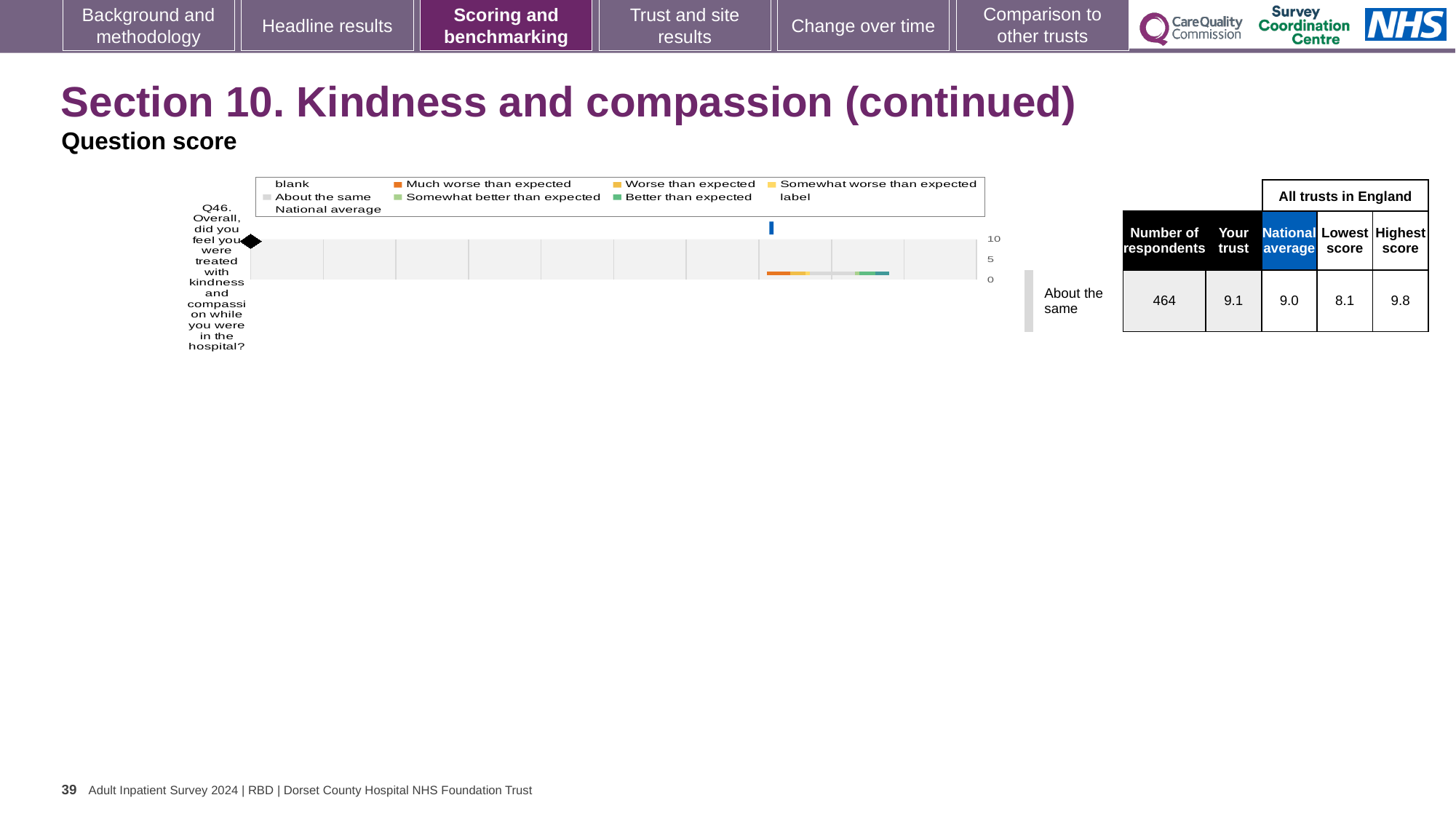
Which question number is plotted on the chart? Q46 According to the table, what is the Highest score among all trusts in England for Q46? 9.8 What kind of chart is shown on the slide? bar chart According to the table, what is the score for Your trust on Q46? 9.1 How many respondents answered Q46 according to the table? 464 What benchmark category is the trust's Q46 score placed in? About the same According to the table, what is the Lowest score among all trusts in England for Q46? 8.1 Which is larger for Q46, the Your trust score or the National average? Your trust How many questions (categories) are plotted on the chart? 1 What is the difference between the Highest score and the Lowest score for Q46? 1.7 According to the table, what is the National average score for Q46? 9.0 What is the highest value shown on the chart's numeric axis? 10